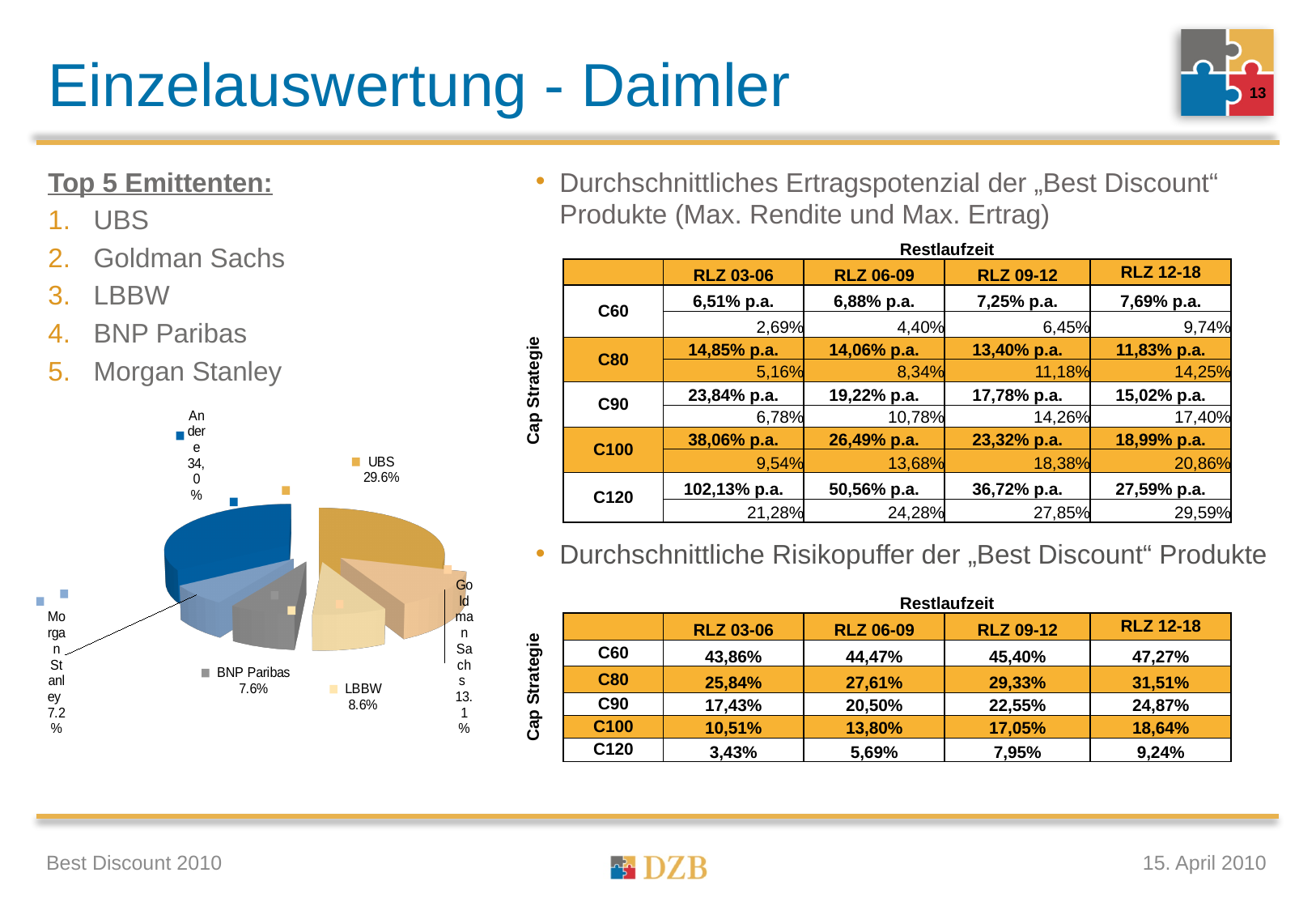
What type of chart is shown on the left of the slide? Pie chart In the pie chart, what share does the 'Andere' slice have? 34,0% In the pie chart, which has the larger share, LBBW or BNP Paribas? LBBW In the pie chart, what share does BNP Paribas have? 7.6% In the pie chart, what share does LBBW have? 8.6% In the pie chart, what share does Morgan Stanley have? 7.2% How many slices does the pie chart have? 6 In the pie chart, how many percentage points larger is UBS's share than Goldman Sachs's share? 16.5 percentage points Which slice of the pie chart is the largest? Andere Which of the named issuers has the smallest slice in the pie chart? Morgan Stanley In the pie chart, what share does Goldman Sachs have? 13.1% In the pie chart, what share does UBS have? 29.6%